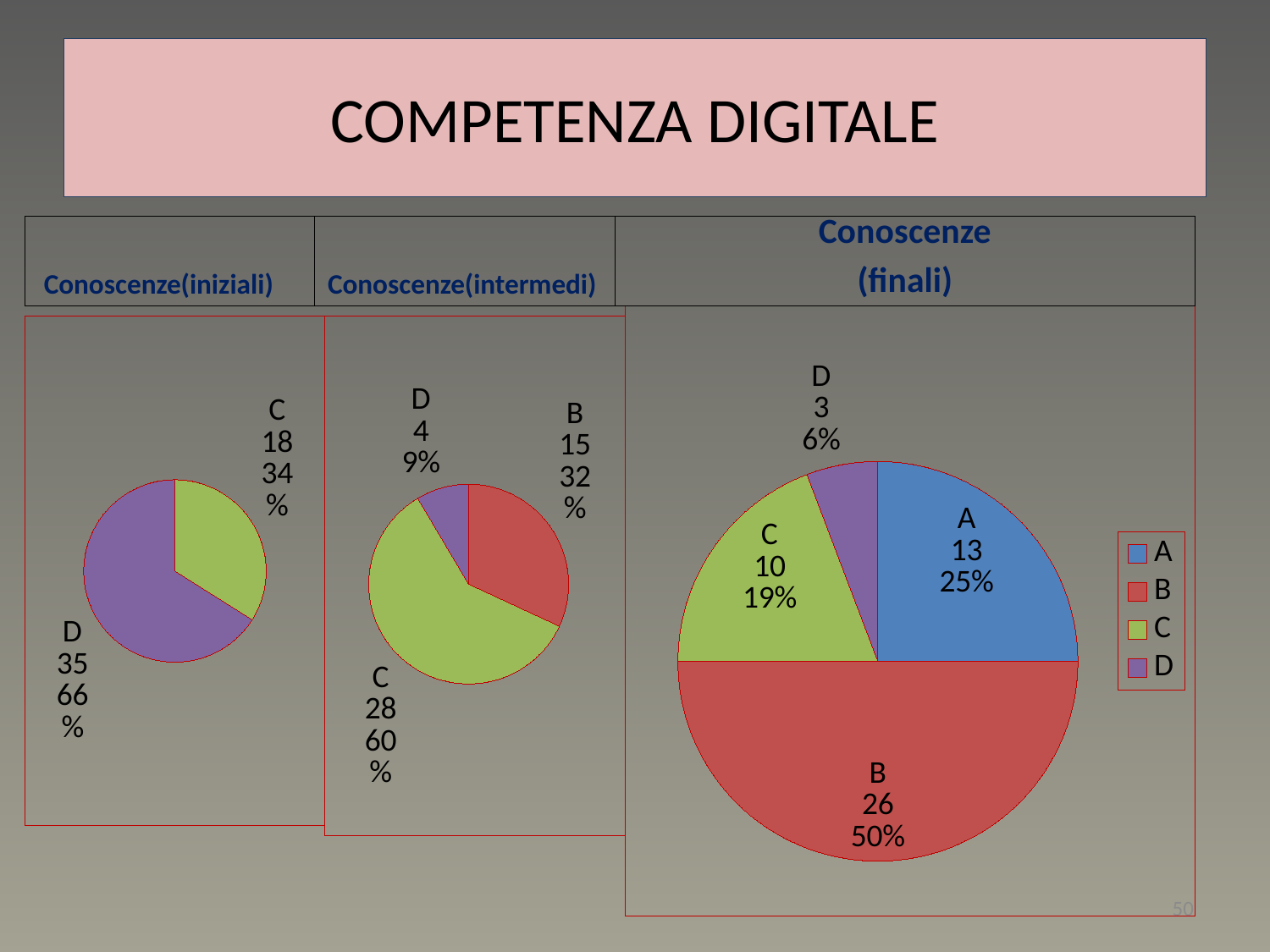
In the Conoscenze(finali) chart, what share of the pie does A represent? 25% In the Conoscenze(iniziali) chart, what is the value for D? 35 In the Conoscenze(intermedi) chart, what share of the pie does B represent? 32% What kind of chart is used for Conoscenze(iniziali)? Pie chart In the Conoscenze(finali) chart, which category has the highest value? B In the Conoscenze(intermedi) chart, which category has the lowest value? D In the Conoscenze(intermedi) chart, what is the value for C? 28 In the Conoscenze(finali) chart, what is the value for B? 26 In the Conoscenze(finali) chart, which is larger, the value for C or the value for D? C In the Conoscenze(iniziali) chart, what share of the pie does C represent? 34% How many categories does the Conoscenze(finali) chart show? 4 In the Conoscenze(finali) chart, what is the difference between the values for B and A? 13